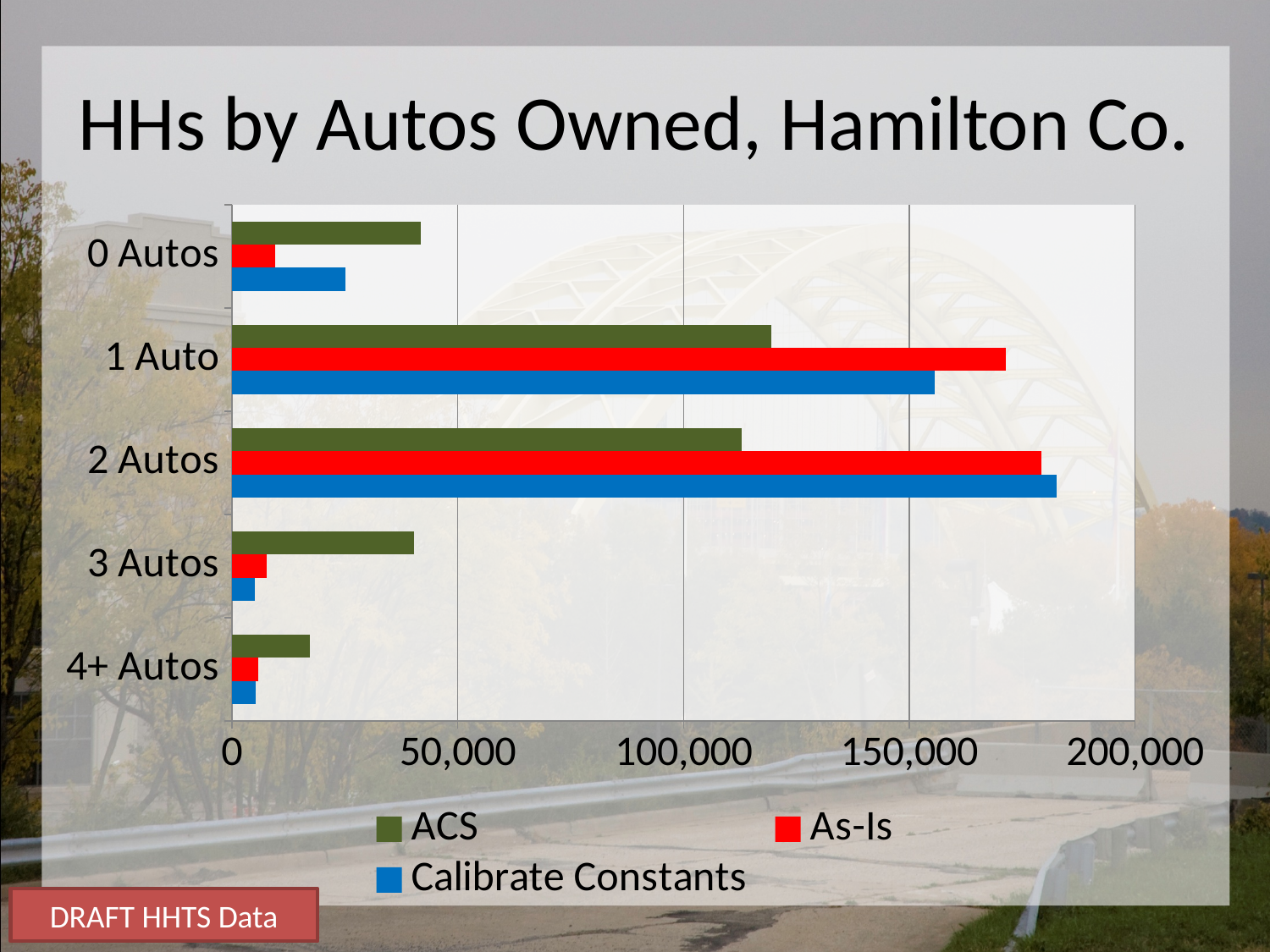
Is the ACS value for 2 Autos greater or less than 100,000? greater Is the As-Is value for 1 Auto greater or less than 150,000? greater Is the ACS value for 0 Autos greater or less than 50,000? less What is the title of the chart? HHs by Autos Owned, Hamilton Co. How many auto-ownership categories are shown on the chart? 5 For 0 Autos, which is larger: the As-Is value or the Calibrate Constants value? Calibrate Constants Which category has the highest ACS value? 1 Auto How many series does the legend list? 3 Which series is shown in red in the legend? As-Is For 1 Auto, which is larger: the ACS value or the As-Is value? As-Is What kind of chart is shown on the slide? Bar chart